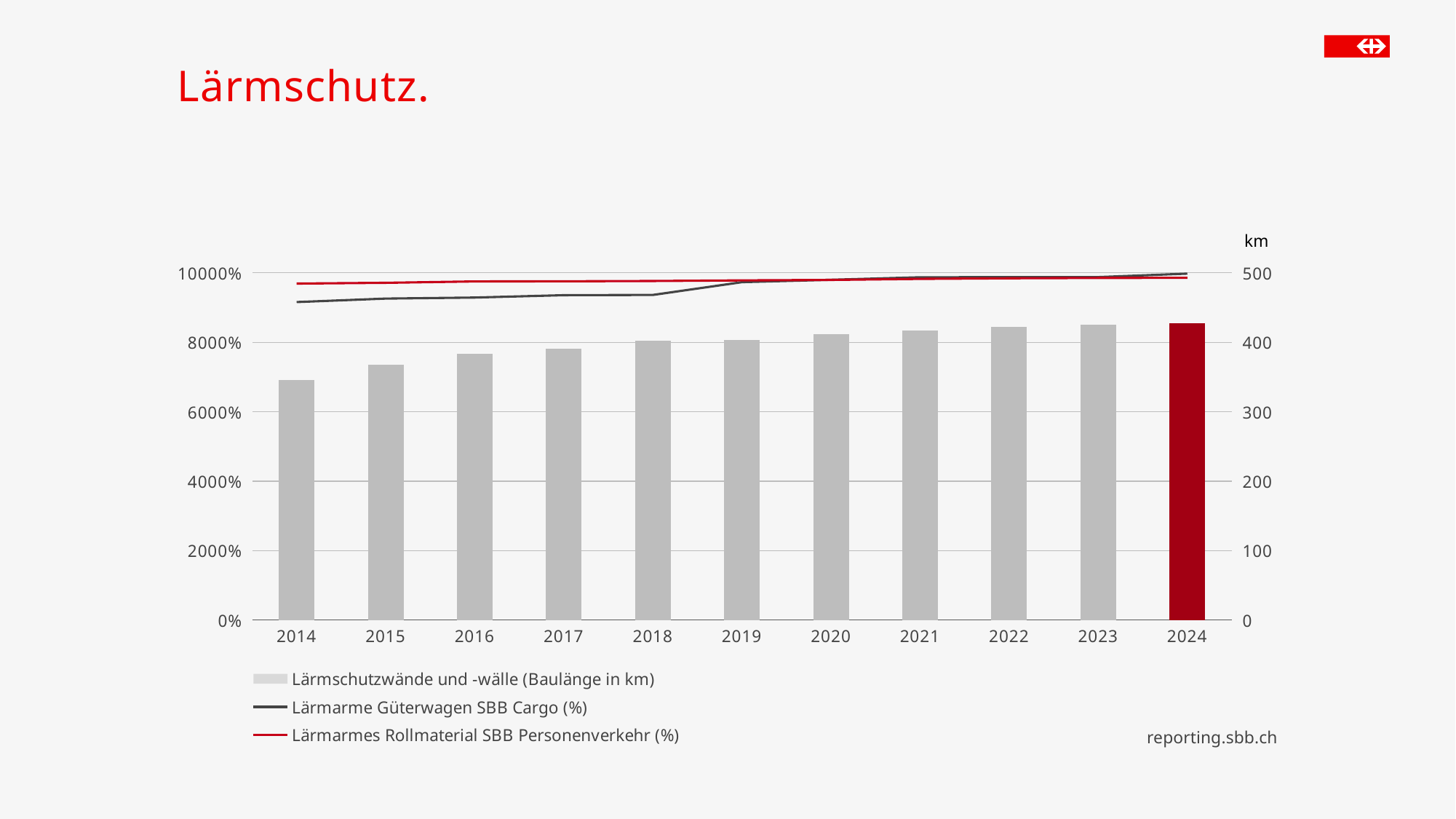
Is the bar value for Lärmschutzwände und -wälle in 2024 greater or less than 400 km? greater What colour is the bar for 2024? Red How many years are shown on the x axis? 11 Which year has the lowest bar for Lärmschutzwände und -wälle (Baulänge in km)? 2014 What is the title of the chart on the slide? Lärmschutz. Which year has the highest bar for Lärmschutzwände und -wälle (Baulänge in km)? 2024 What kind of chart is shown on the slide? A combined bar and line chart Is the bar value for Lärmschutzwände und -wälle in 2016 greater or less than 400 km? less Is the bar value for Lärmschutzwände und -wälle in 2014 greater or less than 300 km? greater How many series does the legend list? 3 Do the bars for Lärmschutzwände und -wälle rise or fall from 2014 to 2024? Rise In 2014, which line is higher: Lärmarme Güterwagen SBB Cargo (%) or Lärmarmes Rollmaterial SBB Personenverkehr (%)? Lärmarmes Rollmaterial SBB Personenverkehr (%)